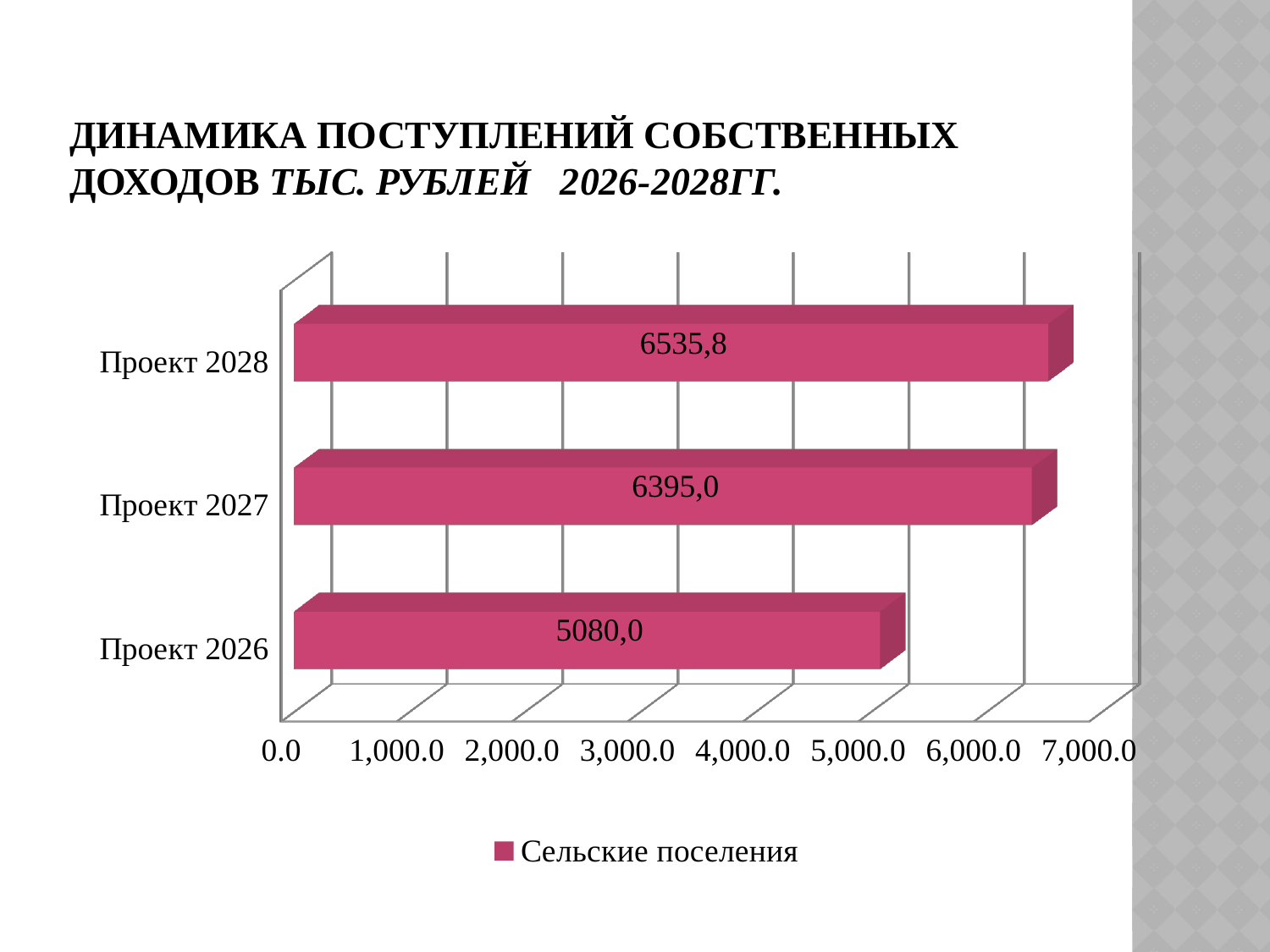
What kind of chart is shown on the slide? bar chart Which is larger, the value for Проект 2027 or the value for Проект 2026? Проект 2027 How many categories are shown in the chart? 3 Which category has the lowest value? Проект 2026 What is the value for Проект 2027? 6395,0 Is the value for Проект 2026 greater or less than 6,000.0? less What is the value for Проект 2026? 5080,0 Which category has the highest value? Проект 2028 What is the difference between the values for Проект 2027 and Проект 2026? 1315,0 What series does the legend list? Сельские поселения What is the difference between the values for Проект 2028 and Проект 2027? 140,8 What is the value for Проект 2028? 6535,8